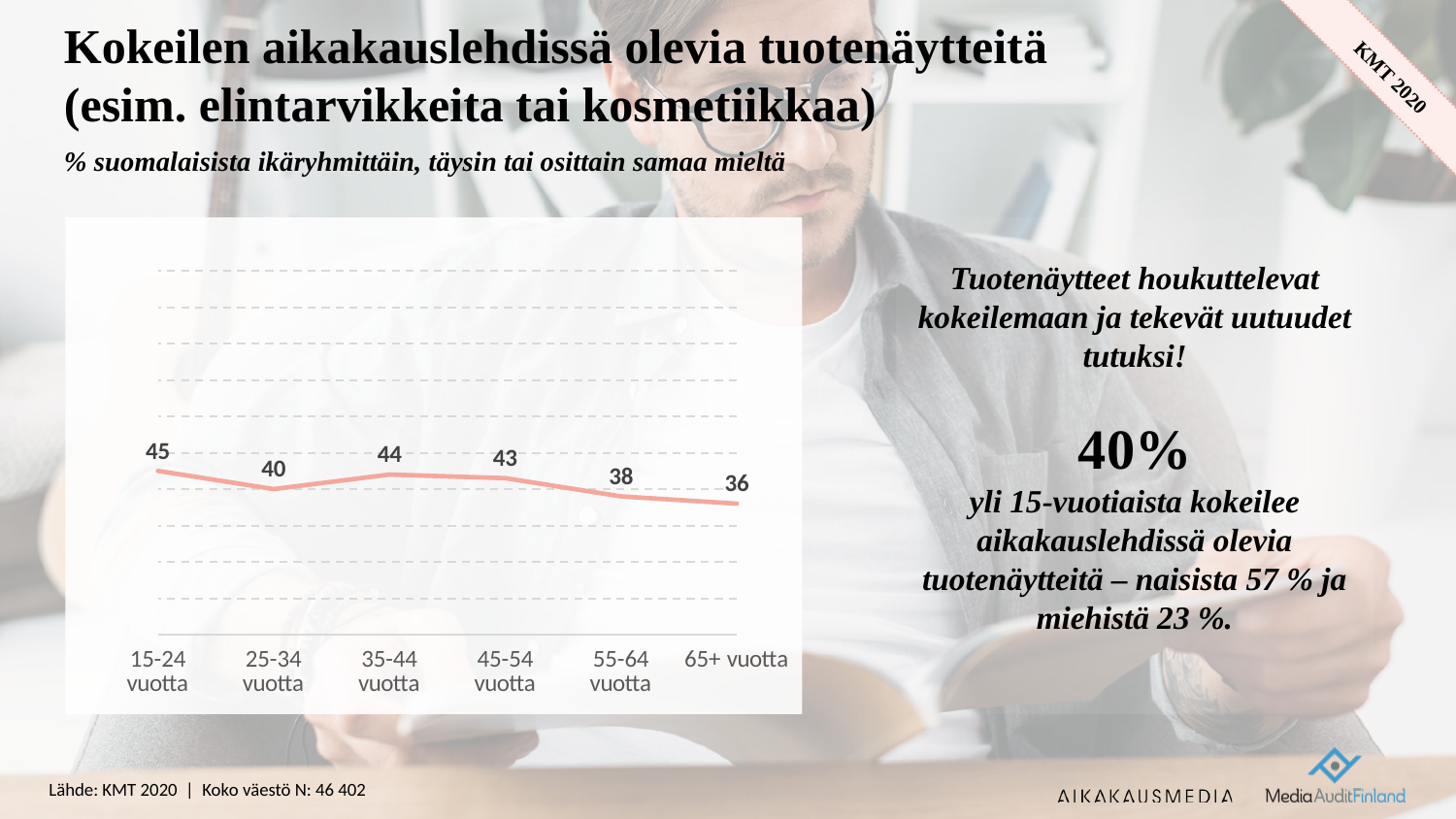
What is the value for the 65+ vuotta age group? 36 Which age group has the highest value? 15-24 vuotta What is the difference between the values for 15-24 vuotta and 65+ vuotta? 9 Which is larger, the value for 35-44 vuotta or the value for 45-54 vuotta? 35-44 vuotta What kind of chart is shown on the slide? Line chart Do the values generally rise or fall from the youngest to the oldest age group? Fall Which age group has the lowest value? 65+ vuotta What is the difference between the values for 35-44 vuotta and 25-34 vuotta? 4 How many age groups are plotted on the chart? 6 What is the value for the 55-64 vuotta age group? 38 What is the value for the 25-34 vuotta age group? 40 What is the value for the 15-24 vuotta age group? 45